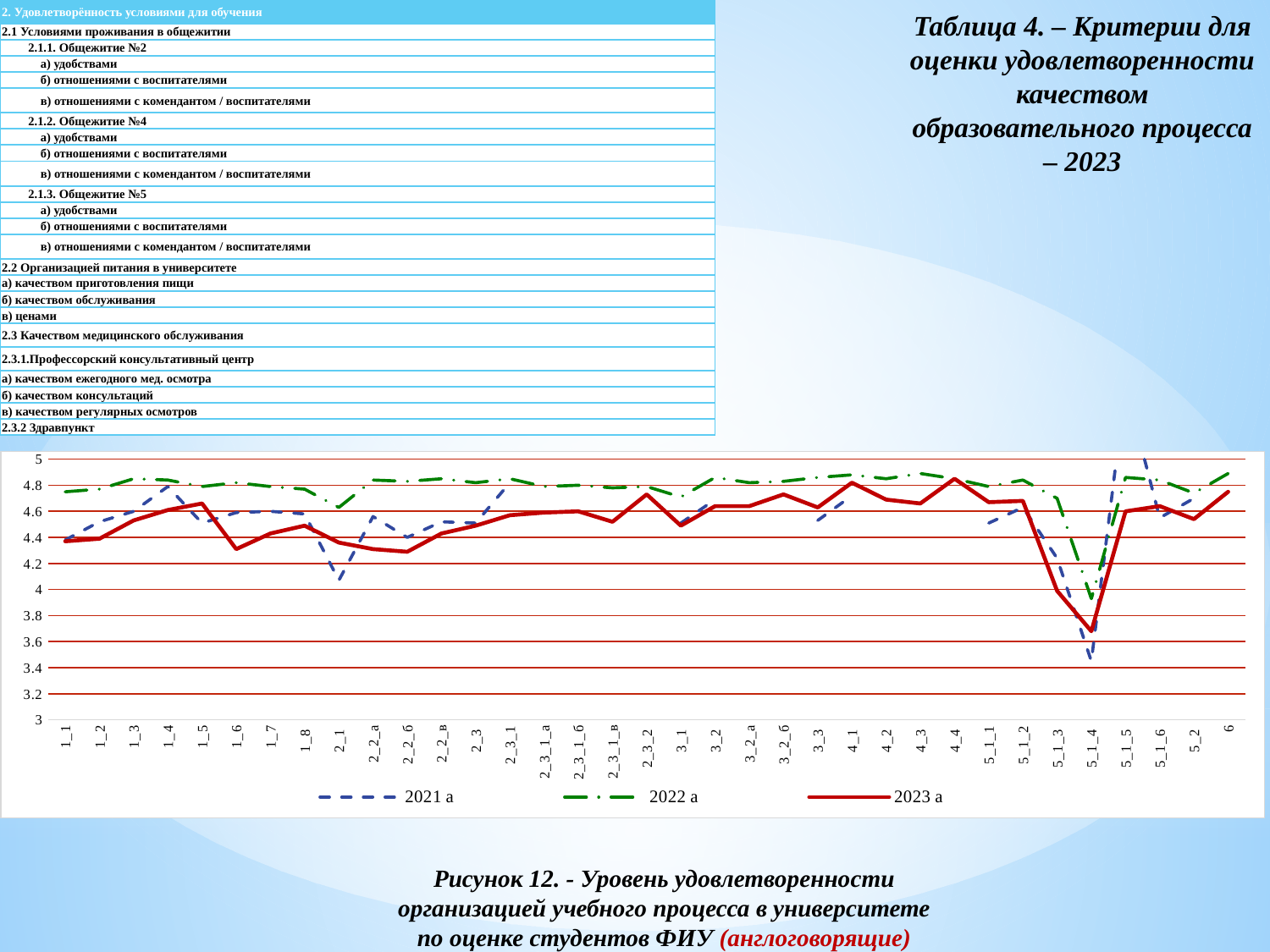
How many series does the legend of the line chart list? 3 Is the value for 2023 а at 5_1_4 greater or less than 3.8? less What kind of chart is shown on the slide? line chart Which category has the lowest value for the 2023 а series? 5_1_4 Is the value for 2022 а at 1_1 greater or less than 4.6? greater How many categories are shown along the x axis of the line chart? 35 Is the value for 2021 а at 5_1_4 greater or less than 3.6? less At category 2_1, which series has the larger value, 2021 а or 2023 а? 2023 а Which series are listed in the legend of the line chart? 2021 а, 2022 а, 2023 а At category 1_6, which series has the larger value, 2022 а or 2023 а? 2022 а Which category has the lowest value for the 2021 а series? 5_1_4